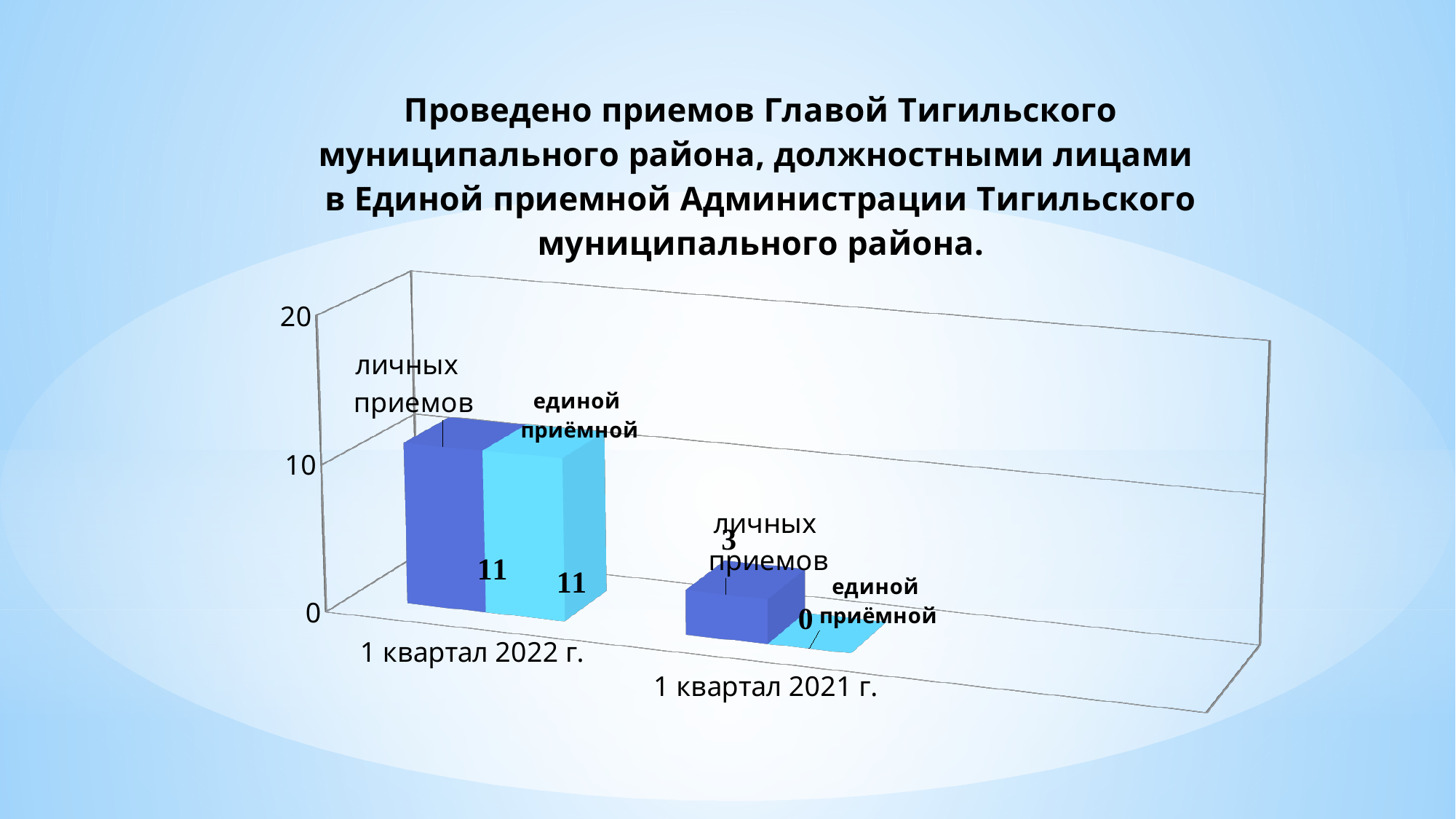
What is the value for единой приёмной in 1 квартал 2021 г.? 0 What is the value for личных приемов in 1 квартал 2021 г.? 3 What type of chart is shown on the slide? bar chart What is the difference between личных приемов in 1 квартал 2022 г. and in 1 квартал 2021 г.? 8 How many categories are shown on the x axis of the chart? 2 What is the value for единой приёмной in 1 квартал 2022 г.? 11 Which category has the lowest value for единой приёмной? 1 квартал 2021 г. What is the value for личных приемов in 1 квартал 2022 г.? 11 What is the highest value shown on the vertical axis of the chart? 20 Is the value for личных приемов in 1 квартал 2022 г. greater or less than 10? greater Which is larger: личных приемов in 1 квартал 2022 г. or личных приемов in 1 квартал 2021 г.? 1 квартал 2022 г. What is the total of the two values shown for 1 квартал 2021 г.? 3